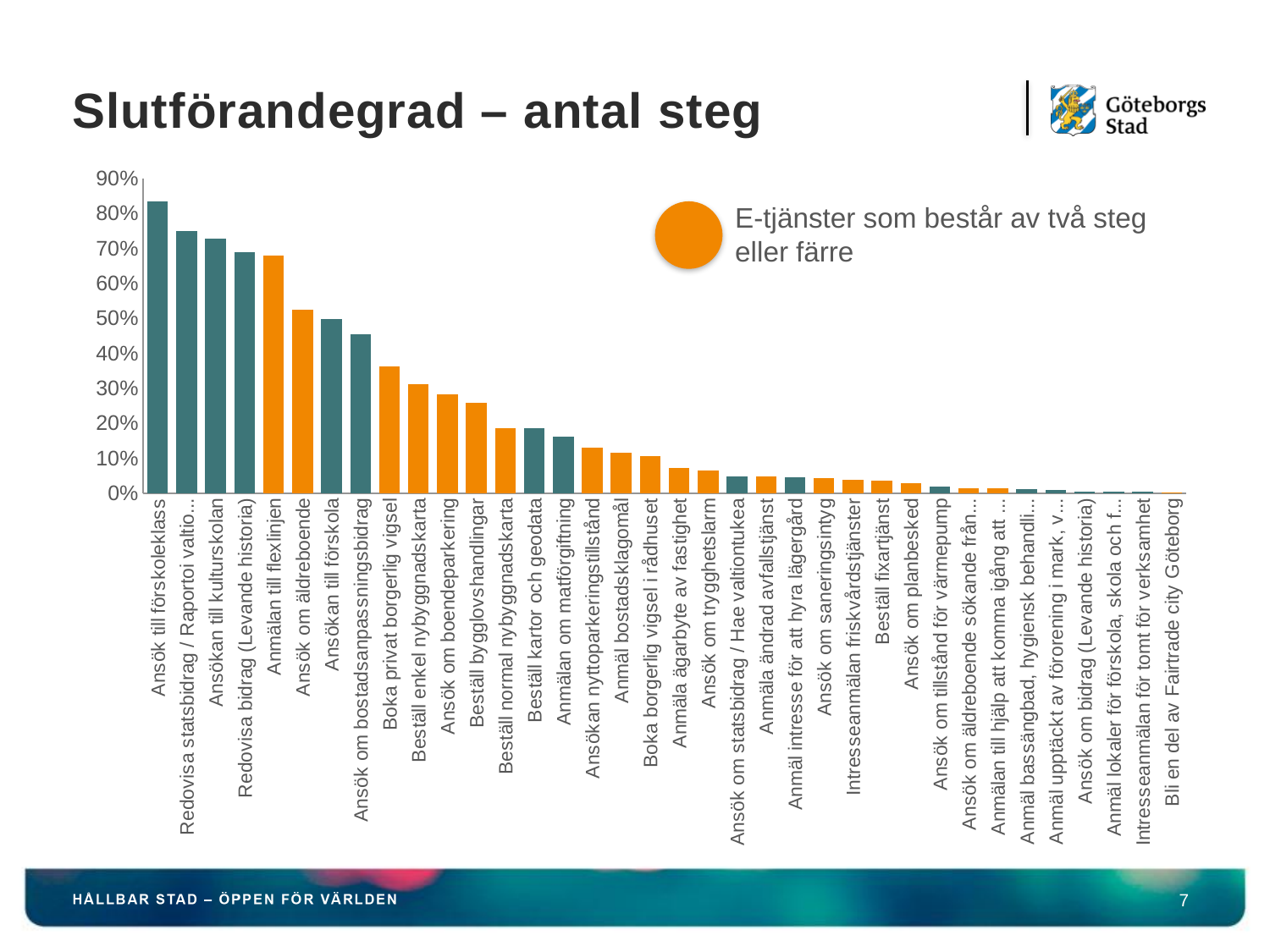
Do the values rise or fall from left to right along the x axis? fall Is the value for Anmälan till flexlinjen greater or less than 70%? less Which category has the lowest value? Bli en del av Fairtrade city Göteborg Is the value for Ansök till förskoleklass greater or less than 80%? greater How many categories are plotted on the x axis? 36 Is the value for Ansök om bostadsanpassningsbidrag greater or less than 50%? less Which is larger, the value for Ansökan till kulturskolan or the value for Redovisa bidrag (Levande historia)? Ansökan till kulturskolan What kind of chart is shown on the slide? bar chart According to the slide, what do the orange bars represent? E-tjänster som består av två steg eller färre Which category has the highest value? Ansök till förskoleklass